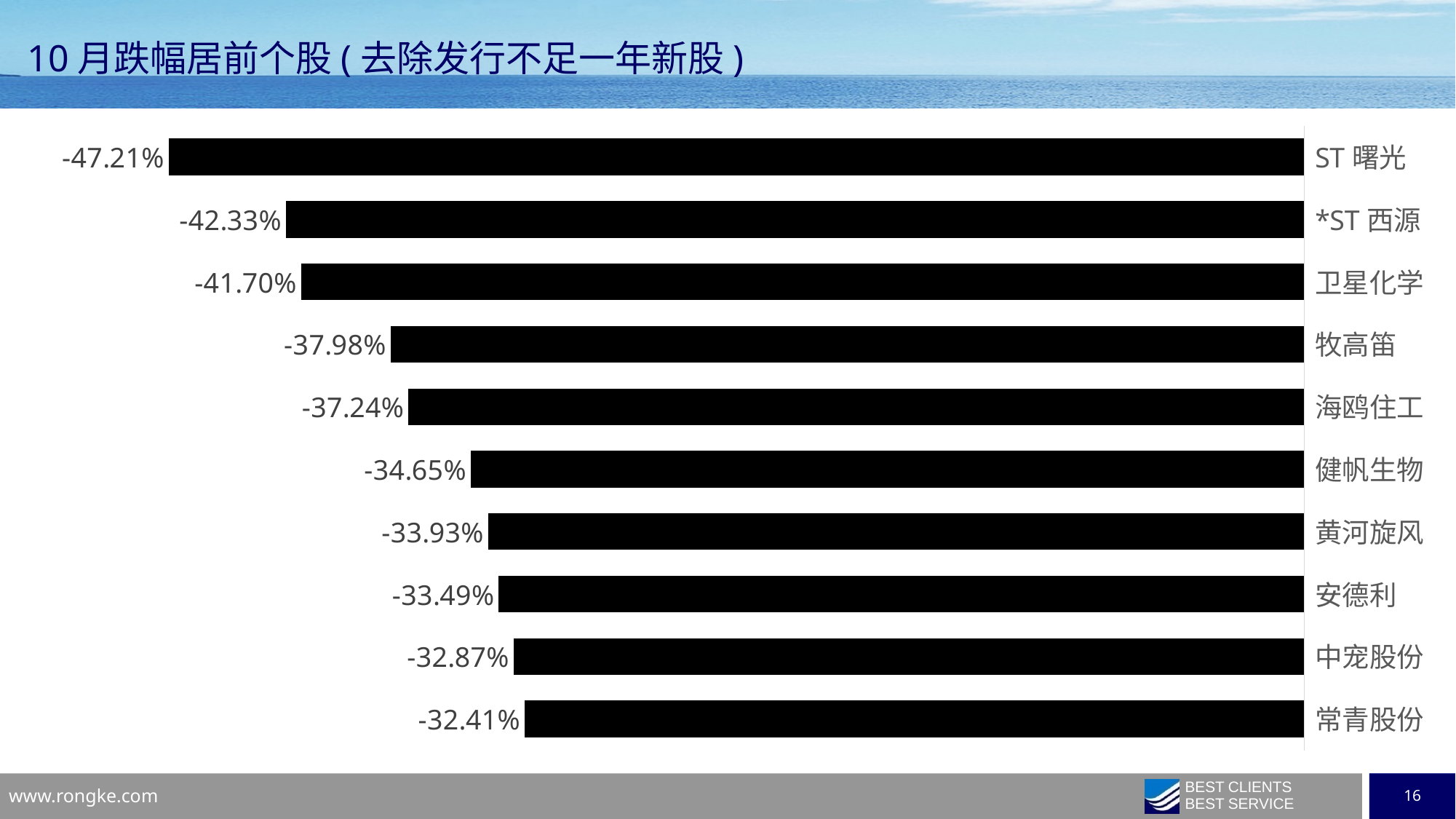
What is the title of the slide? 10 月跌幅居前个股 ( 去除发行不足一年新股 ) Which stock has the smallest decline (highest value) on the chart? 常青股份 Which stock has the largest decline (lowest value) on the chart? ST 曙光 What is the value for 常青股份? -32.41% What is the value for 黄河旋风? -33.93% What is the value for 牧高笛? -37.98% Which stock fell more, 海鸥住工 or 健帆生物? 海鸥住工 What kind of chart is shown on the slide? Bar chart How many stocks are shown on the chart? 10 What is the difference between the values for 卫星化学 and 牧高笛? 3.72 percentage points What is the value for ST 曙光? -47.21% What is the difference between the values for ST 曙光 and *ST 西源? 4.88 percentage points